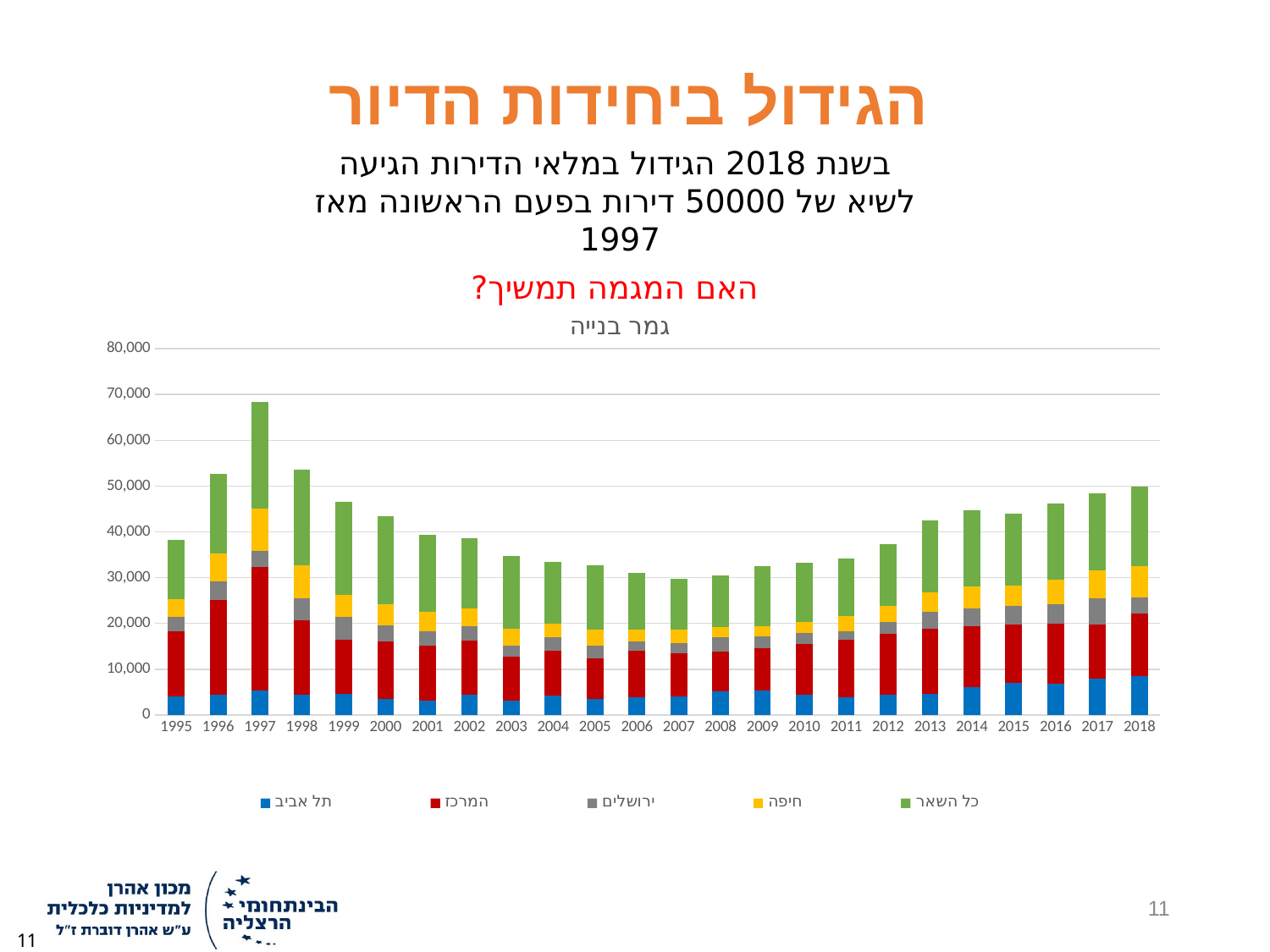
Is the total for 2018 greater or less than 40,000? greater Is the total for 1995 greater or less than 40,000? less Which series is shown in green in the legend? כל השאר Do the total bars rise or fall from 1997 to 2007? fall Which year has the larger total bar, 2007 or 2018? 2018 Is the total for 1997 greater or less than 60,000? greater Which year has the highest total bar? 1997 What kind of chart is shown on the slide? Stacked bar chart How many years are shown along the x axis? 24 How many series does the legend list? 5 What is the title of the chart? גמר בנייה